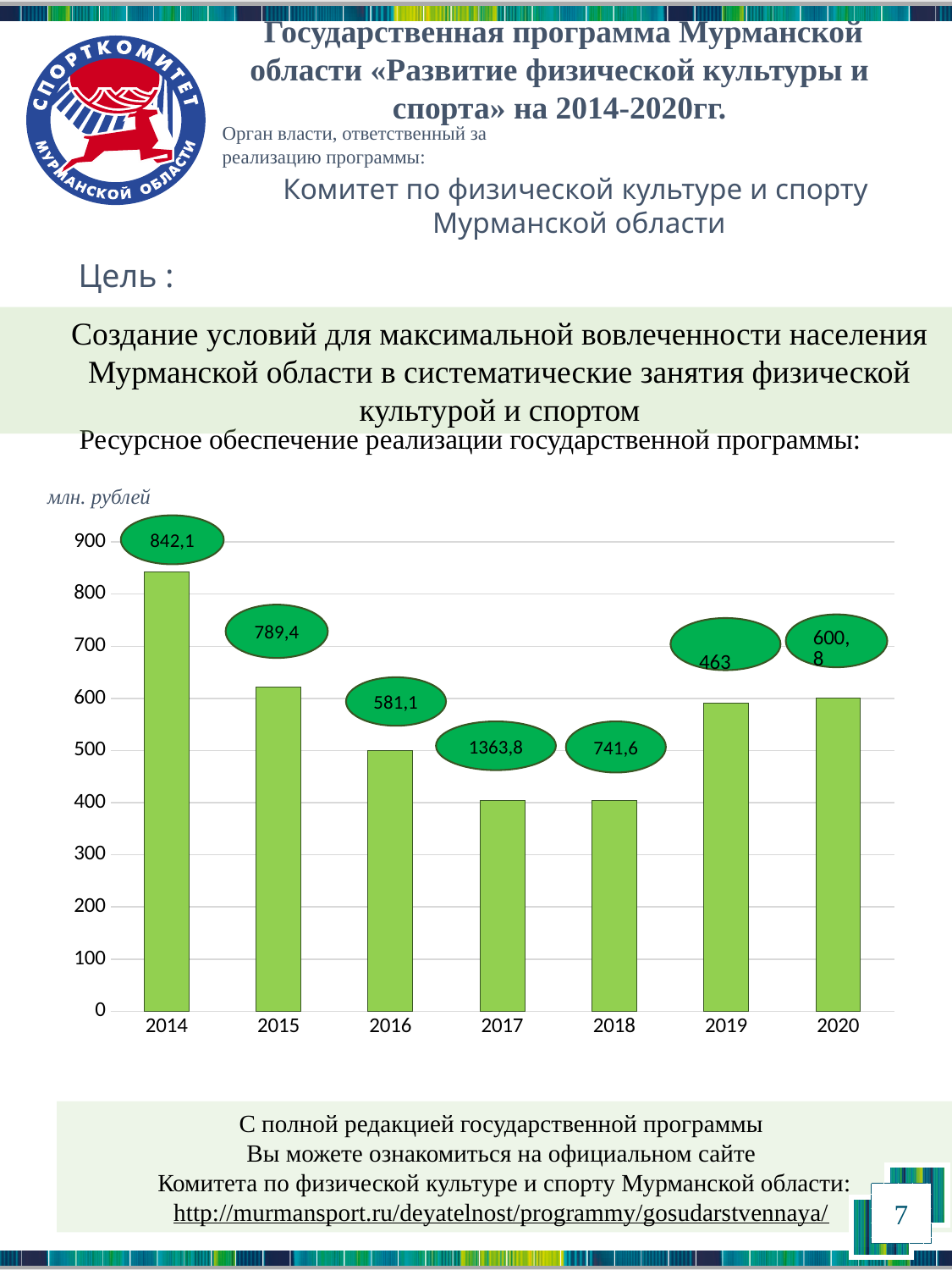
What value is labelled for 2014 in the chart? 842,1 Is the value for 2020 greater or less than 500? greater What unit is given for the values in the chart? млн. рублей Is the value for 2014 greater or less than 800? greater Do the values rise or fall from 2014 to 2016? fall What kind of chart is shown on the slide? bar chart How many years are shown on the x axis of the chart? 7 Is the value for 2019 greater or less than 700? less Which is larger, the value for 2014 or the value for 2015? 2014 What value is labelled for 2020 in the chart? 600,8